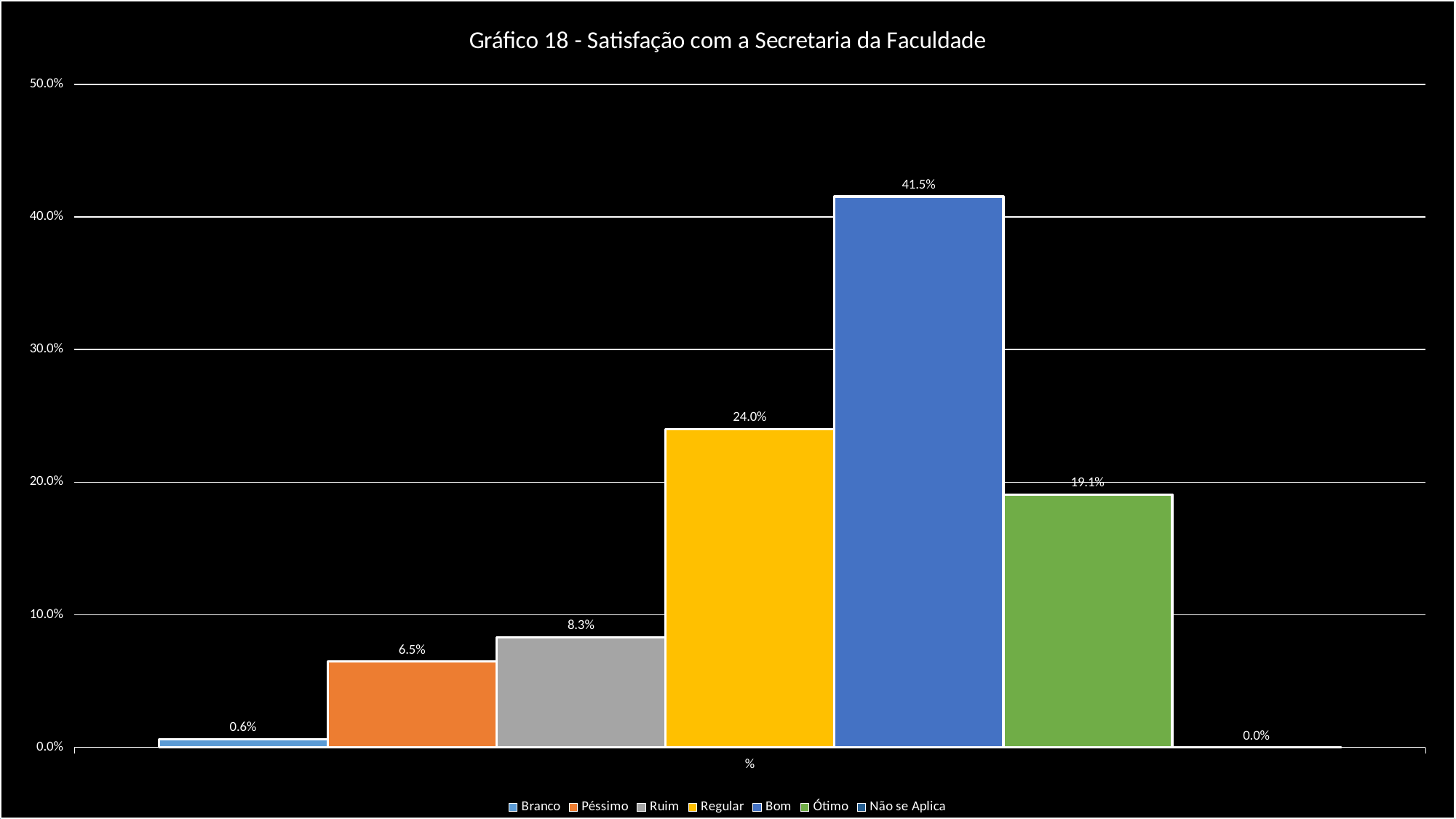
What kind of chart is shown? bar chart What is the title of the chart? Gráfico 18 - Satisfação com a Secretaria da Faculdade What is the difference between the values for Bom and Regular? 17.5% What is the value for Não se Aplica? 0.0% What is the value for Péssimo? 6.5% Which is larger, the value for Ruim or the value for Péssimo? Ruim What is the value for Regular? 24.0% How many series does the legend list? 7 Which series has the highest value? Bom What is the value for Bom? 41.5% Is the value for Ótimo greater or less than 20.0%? less Which series has the lowest value? Não se Aplica